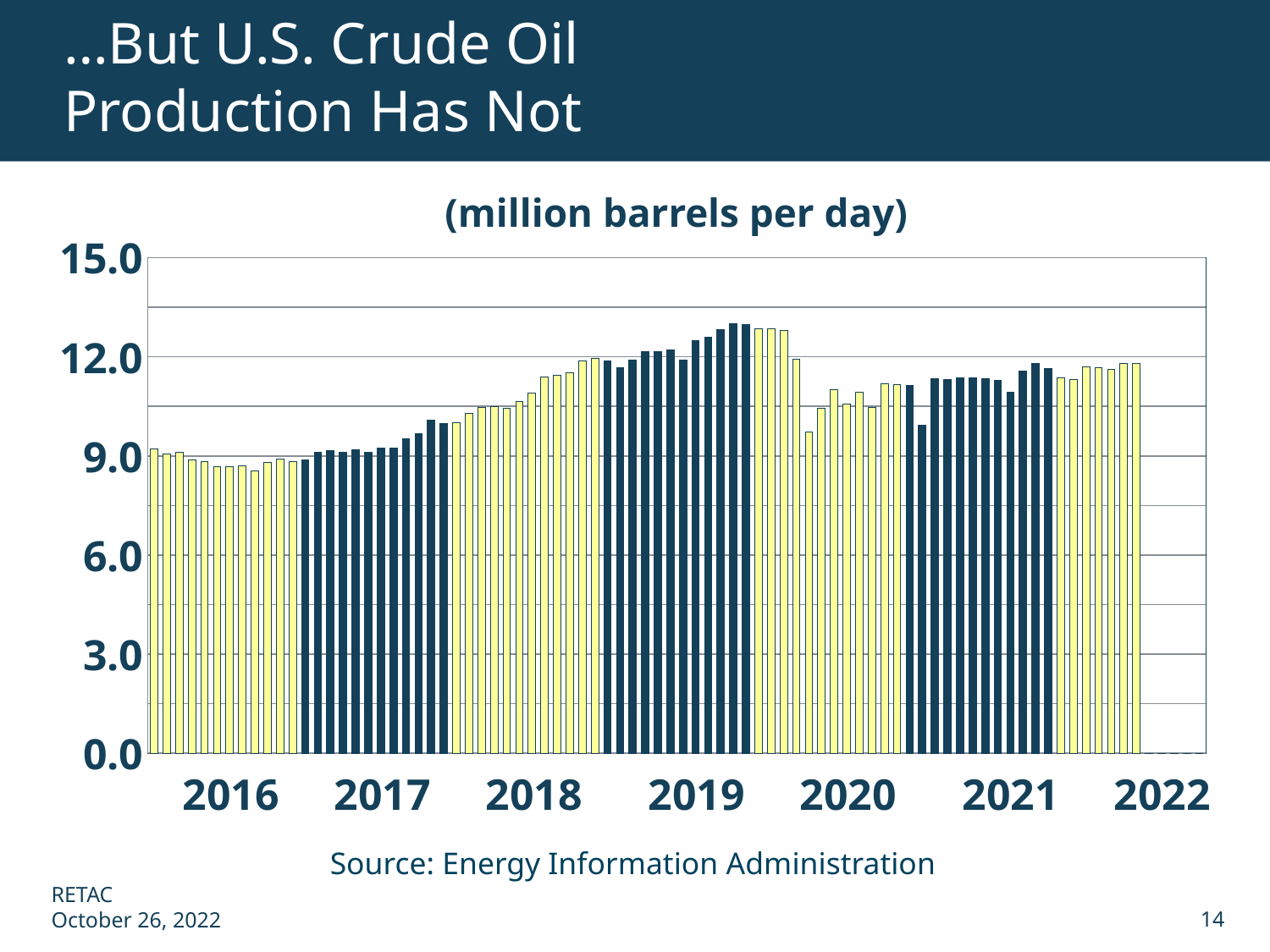
Do the bars generally rise or fall from 2016 to 2019? Rise In which year does the tallest bar on the chart occur? 2019 What kind of chart is shown on the slide? Bar chart Is the first bar of 2016 greater or less than 12.0? less Is the tallest bar in 2019 greater or less than 12.0? greater What is the unit given in the chart title? million barrels per day What is the source cited below the chart? Energy Information Administration Which is higher, the first bar of 2019 or the first bar of 2016? The first bar of 2019 How many year labels appear along the x axis? 7 What is the highest value shown on the y axis? 15.0 In which year does the shortest bar on the chart occur? 2016 Are the bars in 2016 greater or less than 6.0? greater